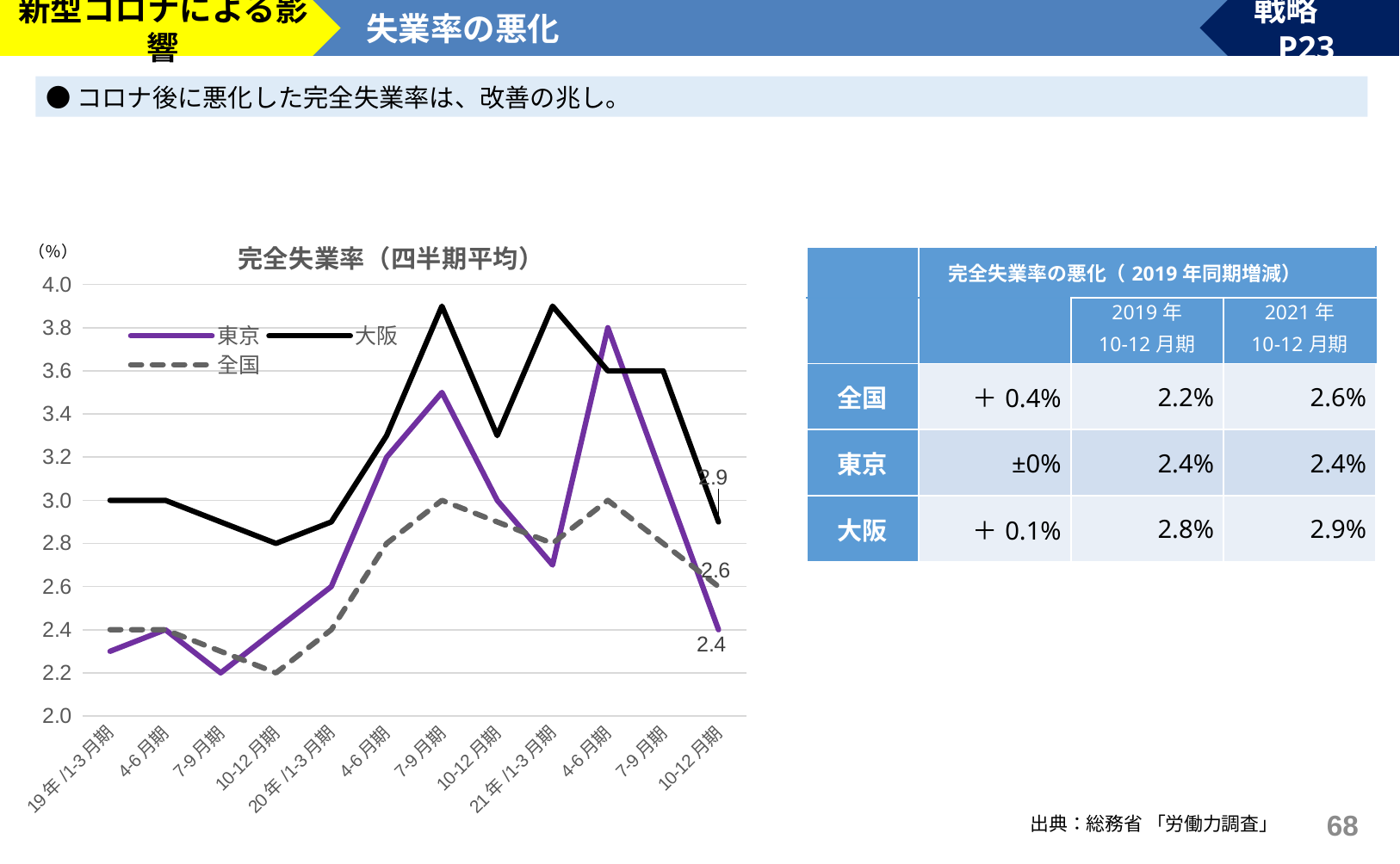
Is the value for 大阪 at 19年/1-3月期 greater or less than 2.8? greater How many quarters are plotted along the x axis of the chart? 12 What kind of chart is shown on the slide? line chart Is the value for 東京 at 7-9月期 of 2019 greater or less than 2.4? less At the last quarter (10-12月期 of 2021), which is larger, the value for 大阪 or the value for 東京? 大阪 Does the 東京 line rise or fall from 4-6月期 of 2021 to 10-12月期 of 2021? fall What is the value for 東京 at the last quarter (10-12月期 of 2021) in the chart? 2.4 What is the value for 大阪 at the last quarter (10-12月期 of 2021) in the chart? 2.9 How many series does the legend of the chart list? 3 Which series has the lowest value at the last quarter (10-12月期 of 2021)? 東京 At the last quarter (10-12月期 of 2021), what is the difference between the value for 大阪 and the value for 東京? 0.5 What is the value for 全国 at the last quarter (10-12月期 of 2021) in the chart? 2.6